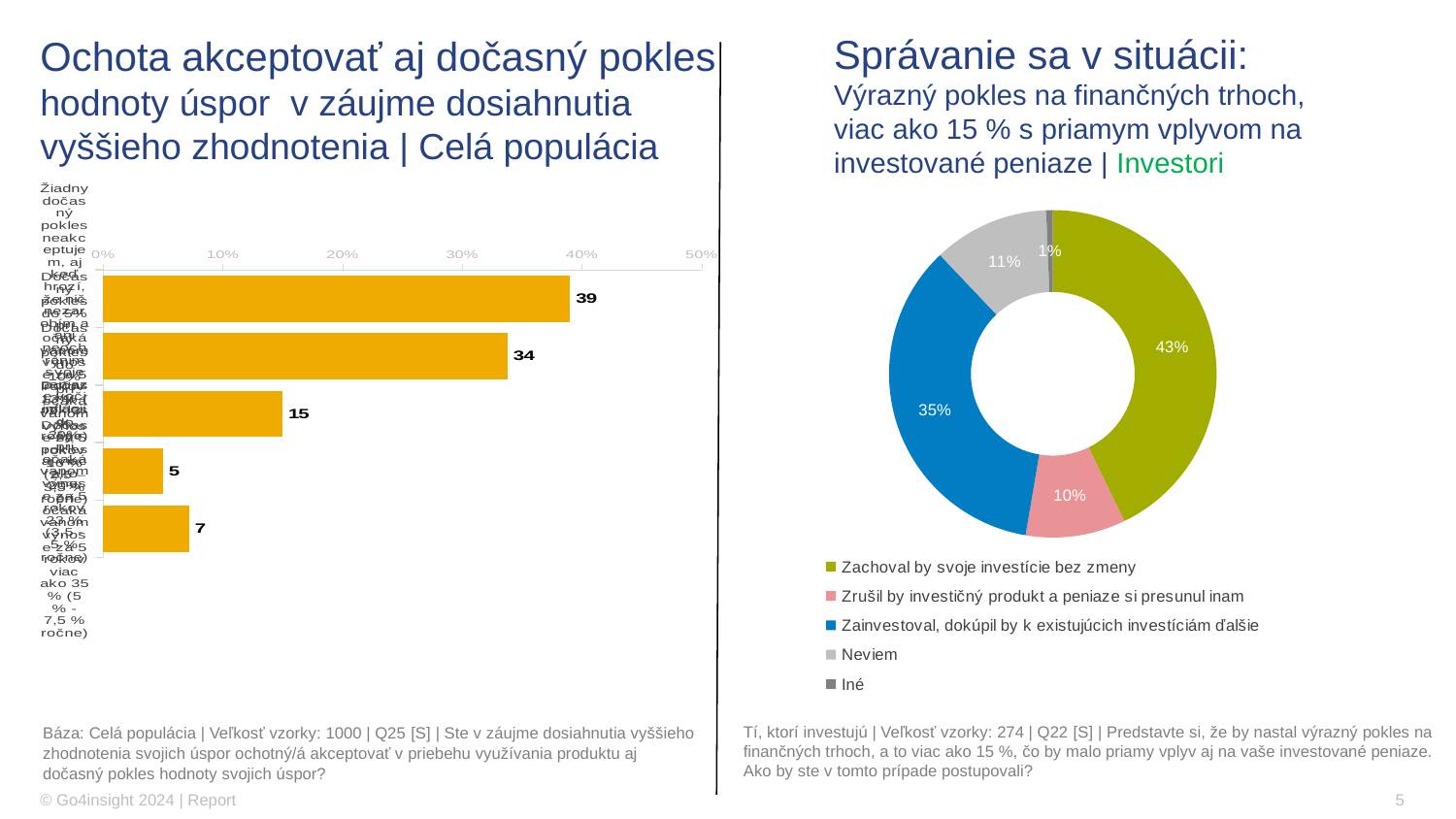
How many entries does the legend of the doughnut chart on the right list? 5 In the doughnut chart on the right, which is larger: 'Zrušil by investičný produkt a peniaze si presunul inam' or 'Neviem'? Neviem How many bars are plotted in the bar chart on the left? 5 In the doughnut chart on the right, what share is shown for 'Zainvestoval, dokúpil by k existujúcich investíciám ďalšie'? 35% In the doughnut chart on the right, what share is shown for 'Zachoval by svoje investície bez zmeny'? 43% In the doughnut chart on the right, which category has the largest share? Zachoval by svoje investície bez zmeny In the bar chart on the left, what is the highest value shown on a bar? 39 In the doughnut chart on the right, what share is shown for 'Neviem'? 11% In the doughnut chart on the right, what is the difference in percentage points between 'Zachoval by svoje investície bez zmeny' and 'Zainvestoval, dokúpil by k existujúcich investíciám ďalšie'? 8 percentage points What kind of chart is shown on the right side of the slide (Správanie sa v situácii)? Doughnut (pie) chart In the doughnut chart on the right, which category has the smallest share? Iné What kind of chart is shown on the left side of the slide (Ochota akceptovať aj dočasný pokles)? Bar chart